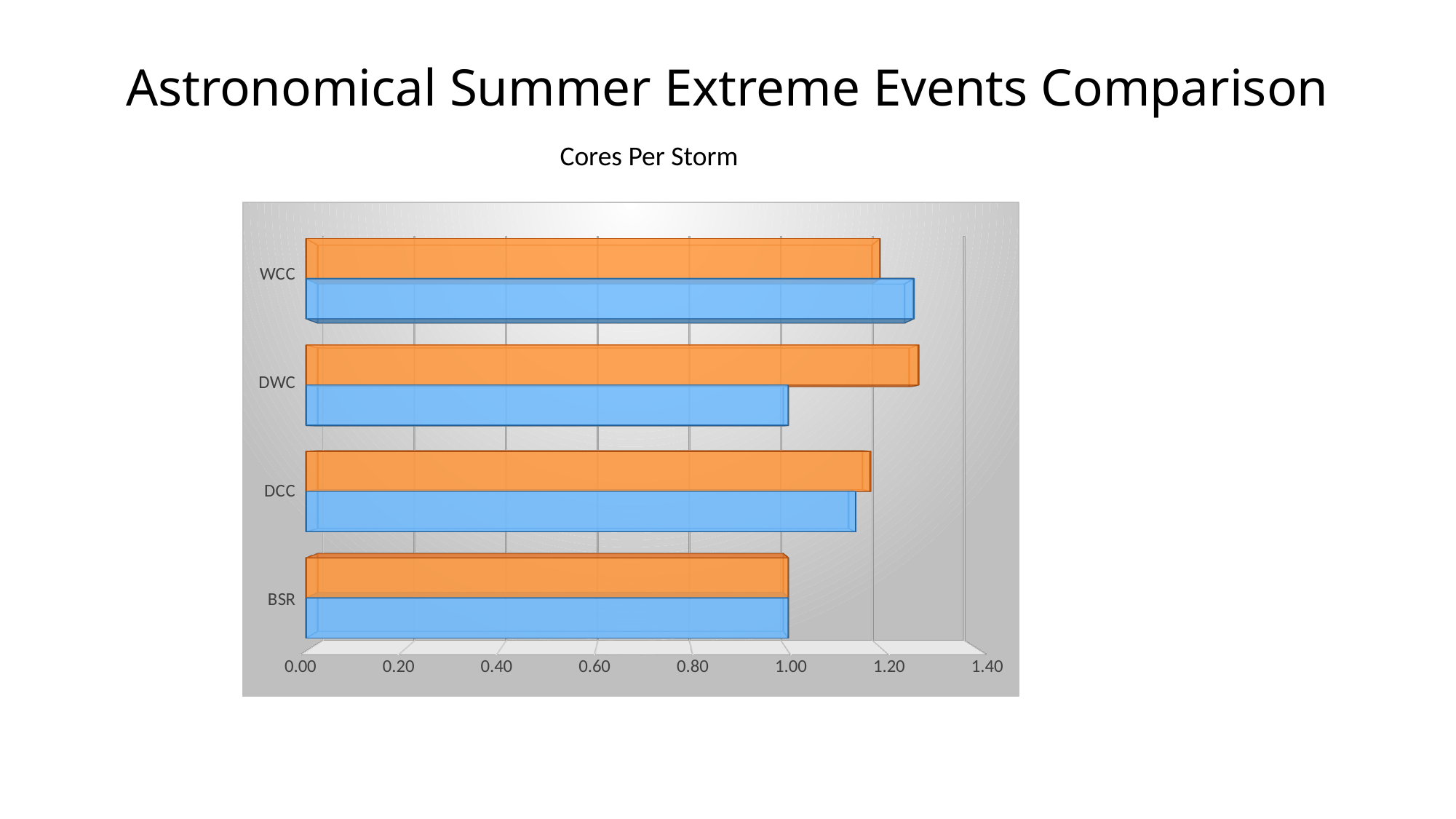
Is the orange bar for DWC greater or less than 1.20? greater Which category has the shortest orange bar? BSR For WCC, is the orange bar or the blue bar longer? blue For DWC, is the orange bar or the blue bar longer? orange What is the title of the chart? Cores Per Storm Which category has the longest blue bar? WCC How many categories are shown on the chart? 4 Is the blue bar for DCC greater or less than 1.20? less How many bars are plotted for each category? 2 What kind of chart is shown on the slide? bar chart Which category has the longest orange bar? DWC Is the orange bar for WCC greater or less than 1.00? greater